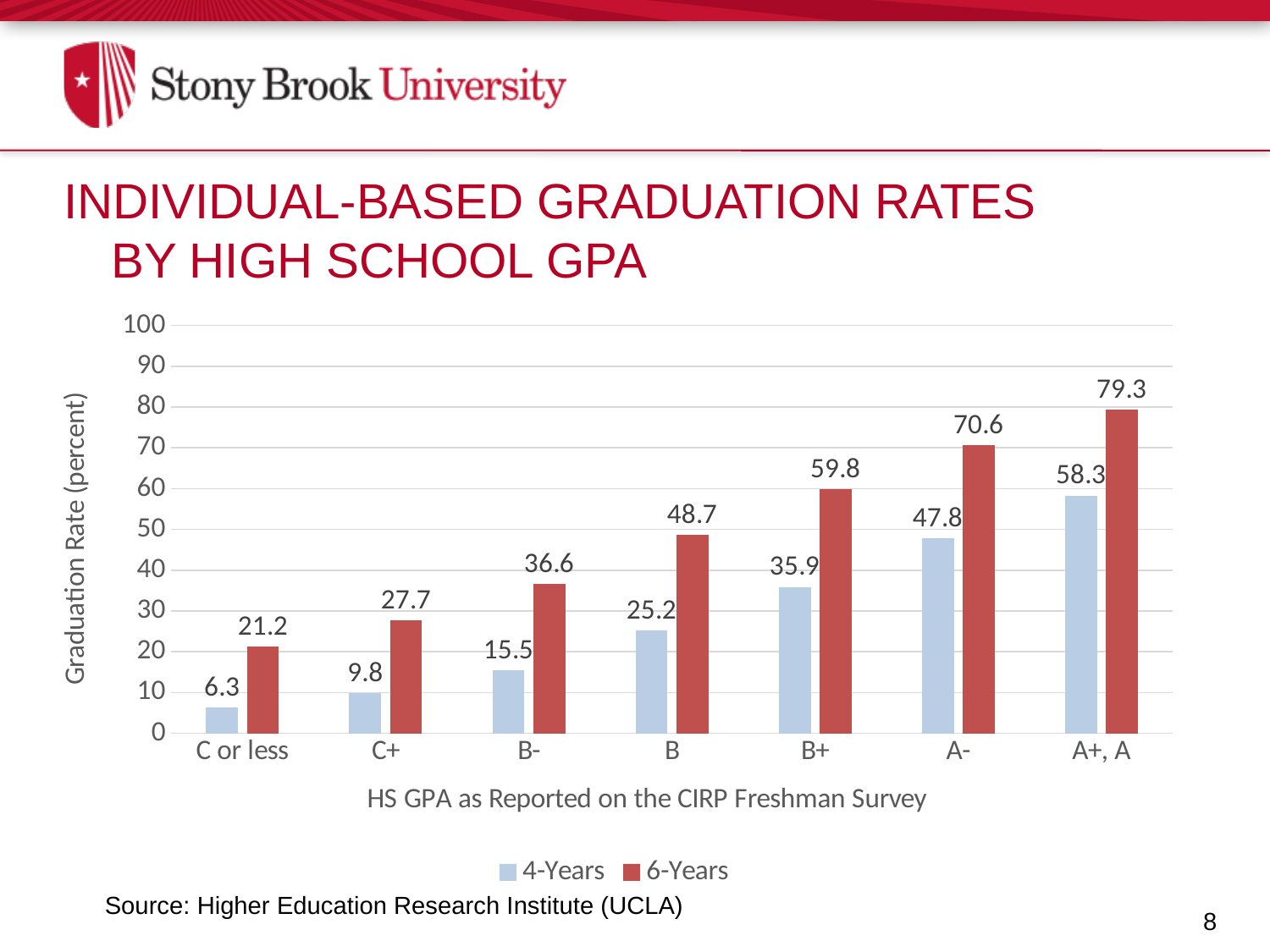
Which GPA category has the lowest 4-Years graduation rate? C or less What is the 4-Years graduation rate for students with a high school GPA of A-? 47.8 Which is larger: the 4-Years rate for A+, A or the 6-Years rate for B+? 6-Years rate for B+ What is the 6-Years graduation rate for students with a high school GPA of B? 48.7 Do the 6-Years graduation rates rise or fall as high school GPA increases from 'C or less' to 'A+, A'? Rise What is the difference between the 6-Years and 4-Years graduation rates for the A+, A category? 21.0 Which GPA category has the highest 6-Years graduation rate? A+, A How many series does the legend list? 2 What type of chart is shown on the slide? Bar chart What is the difference between the 6-Years graduation rates for B+ and B-? 23.2 What is the 4-Years graduation rate for the 'C or less' GPA category? 6.3 How many GPA categories are shown on the x axis? 7